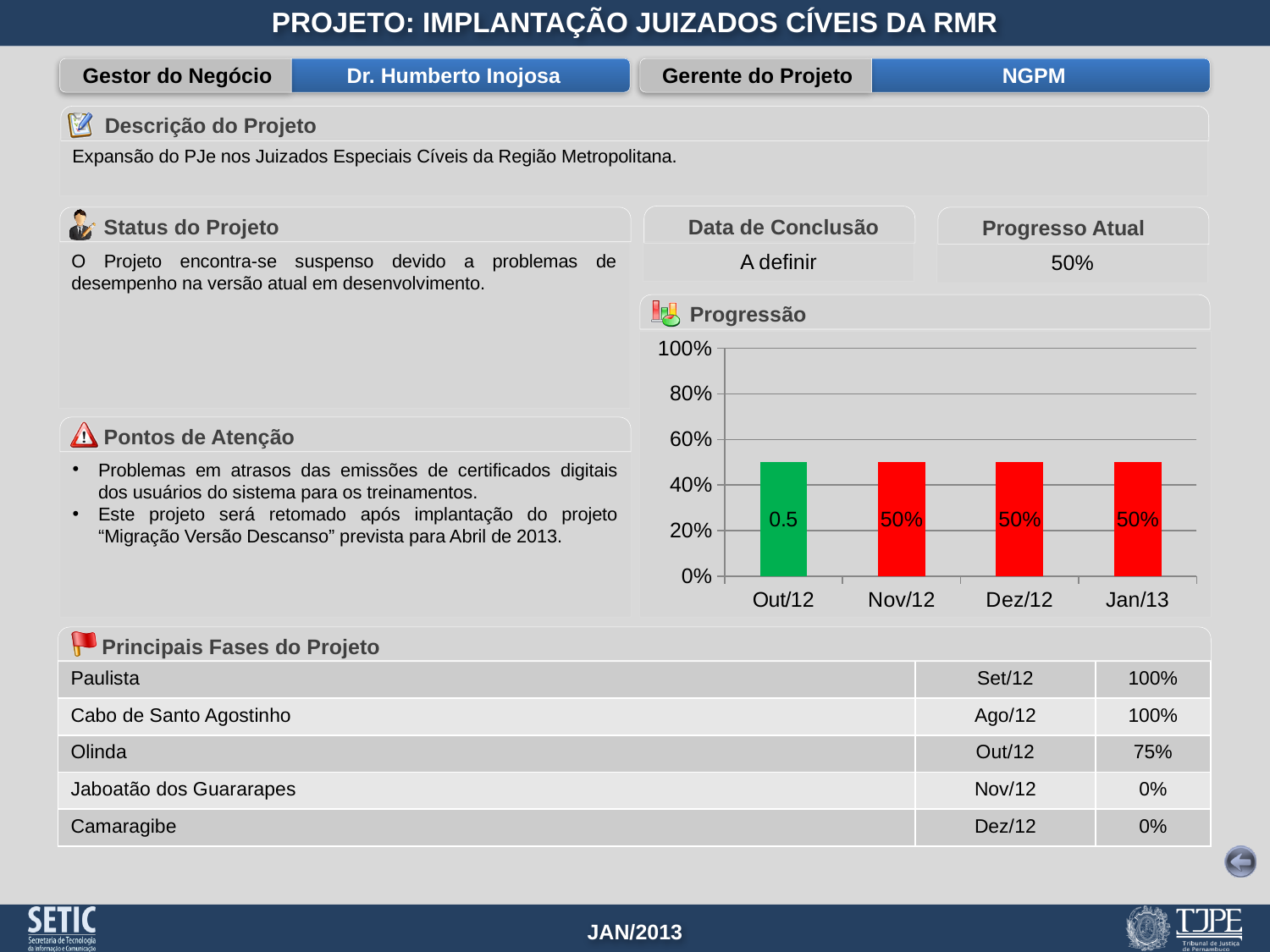
What colour is the Out/12 bar in the Progressão chart? green Is the value for Jan/13 in the Progressão chart greater or less than 60%? less How many categories are plotted on the x axis of the Progressão chart? 4 What is the value shown for Dez/12 in the Progressão chart? 50% What data label is printed on the Out/12 bar in the Progressão chart? 0.5 What is the value shown for Jan/13 in the Progressão chart? 50% Is the value for Dez/12 in the Progressão chart greater or less than 40%? greater Do the values in the Progressão chart rise, fall, or stay flat from Out/12 to Jan/13? stay flat What is the difference between the values for Nov/12 and Dez/12 in the Progressão chart? 0% What kind of chart is the Progressão chart? bar chart What is the title of the chart on the slide? Progressão What is the value shown for Nov/12 in the Progressão chart? 50%